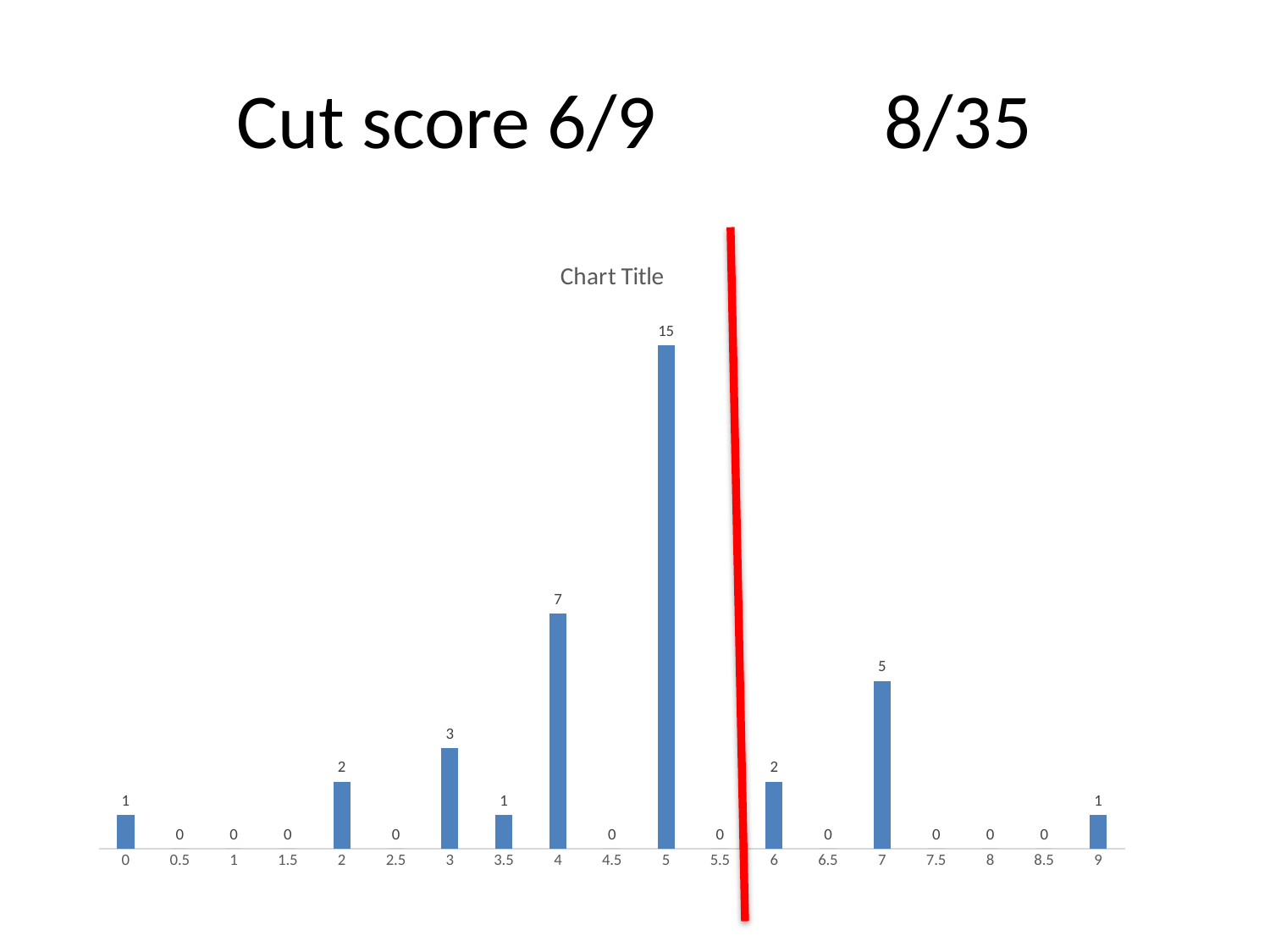
What is the value for category 4? 7 What is the title shown above the chart? Chart Title Which is larger, the value for category 4 or the value for category 7? 4 Which category has the highest value? 5 What is the value for category 9? 1 What is the value for category 3? 3 What is the value for category 5? 15 What kind of chart is shown? bar chart How many categories are shown on the x axis? 19 What is the difference between the values for categories 5 and 4? 8 What is the value for category 7? 5 What is the difference between the values for categories 7 and 6? 3